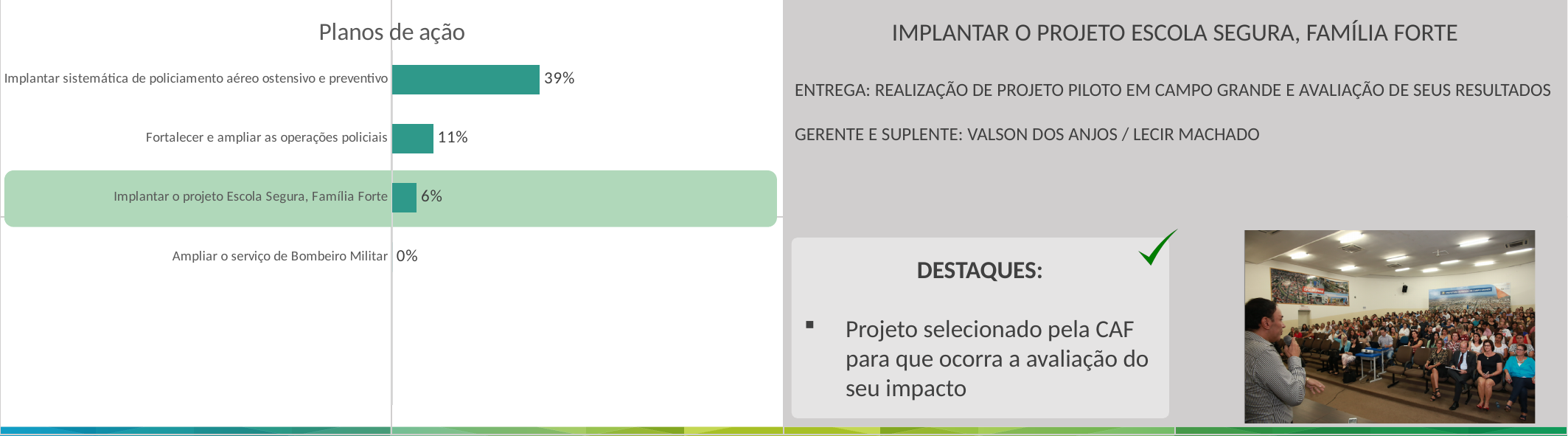
What is the title of the chart? Planos de ação Which is larger: the value for "Fortalecer e ampliar as operações policiais" or for "Implantar o projeto Escola Segura, Família Forte"? Fortalecer e ampliar as operações policiais What is the value for "Fortalecer e ampliar as operações policiais"? 11% What is the value for "Implantar o projeto Escola Segura, Família Forte"? 6% What kind of chart is shown on the slide? Bar chart How many categories are shown in the chart? 4 Which category has the lowest value? Ampliar o serviço de Bombeiro Militar What is the difference between the values for "Implantar sistemática de policiamento aéreo ostensivo e preventivo" and "Fortalecer e ampliar as operações policiais"? 28% What is the value for "Ampliar o serviço de Bombeiro Militar"? 0% Which category has the highest value? Implantar sistemática de policiamento aéreo ostensivo e preventivo What is the difference between the values for "Fortalecer e ampliar as operações policiais" and "Implantar o projeto Escola Segura, Família Forte"? 5% What is the value for "Implantar sistemática de policiamento aéreo ostensivo e preventivo"? 39%